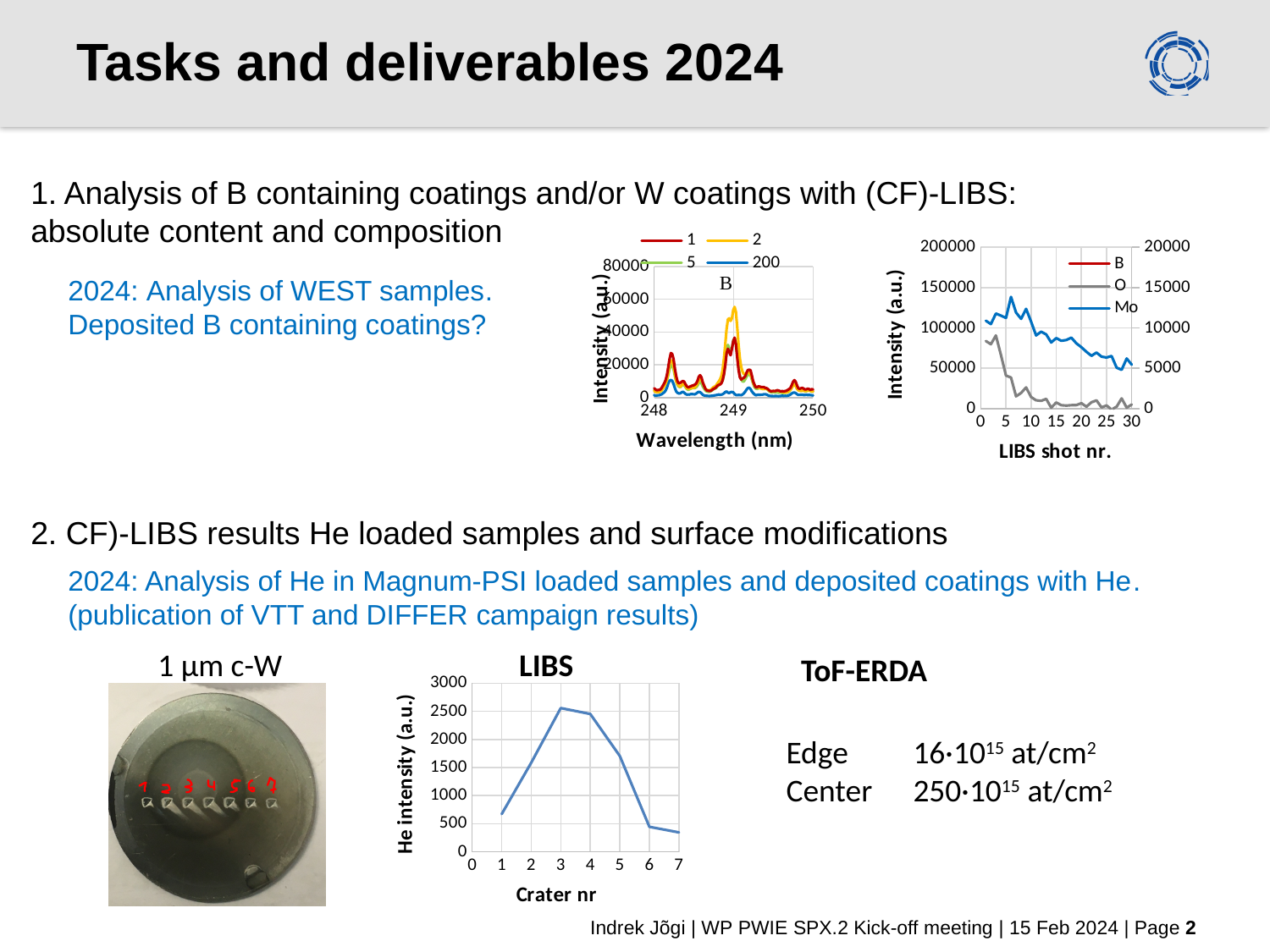
In the top-right chart with LIBS shot nr. on the x axis, does the O series rise or fall as the shot number increases? fall In the top-right chart with LIBS shot nr. on the x axis, how many series does the legend list? 3 In the bottom chart titled LIBS, is the He intensity for crater 4 greater or less than 2000? greater In the bottom chart titled LIBS, which has the higher He intensity, crater 3 or crater 5? crater 3 In the top-left chart with Wavelength (nm) on the x axis, how many series does the legend list? 4 In the bottom chart titled LIBS, which crater nr has the highest He intensity? 3 In the bottom chart titled LIBS, is the He intensity for crater 1 greater or less than 1000? less In the bottom chart titled LIBS, which crater nr has the lowest He intensity? 7 In the top-left chart with Wavelength (nm) on the x axis, what kind of chart is it? line chart In the top-left chart with Wavelength (nm) on the x axis, which element label is written above the main peak near 249 nm? B In the bottom chart titled LIBS, how many crater points are plotted? 7